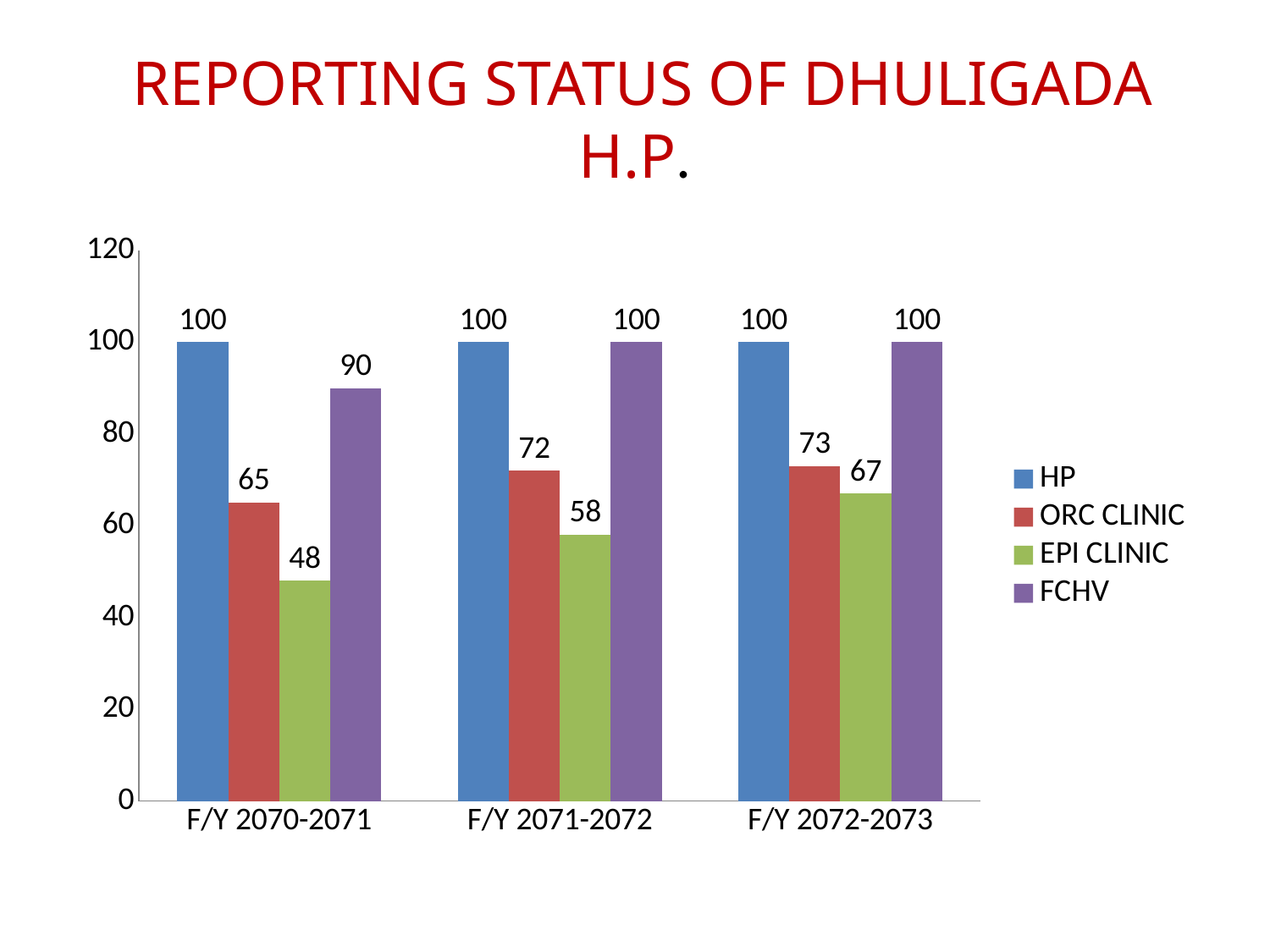
What is the difference between the ORC CLINIC and EPI CLINIC values in F/Y 2070-2071? 17 What is the value for FCHV in F/Y 2070-2071? 90 How many series does the legend list? 4 What kind of chart is shown on the slide? Bar chart What is the value for EPI CLINIC in F/Y 2072-2073? 67 Do the EPI CLINIC values rise or fall across the fiscal years from F/Y 2070-2071 to F/Y 2072-2073? Rise What colour represents FCHV in the chart? Purple What is the value for EPI CLINIC in F/Y 2070-2071? 48 Which is larger in F/Y 2072-2073, ORC CLINIC or EPI CLINIC? ORC CLINIC How many fiscal year categories are shown on the x axis? 3 Which series has the lowest value in F/Y 2071-2072? EPI CLINIC What is the value for ORC CLINIC in F/Y 2071-2072? 72